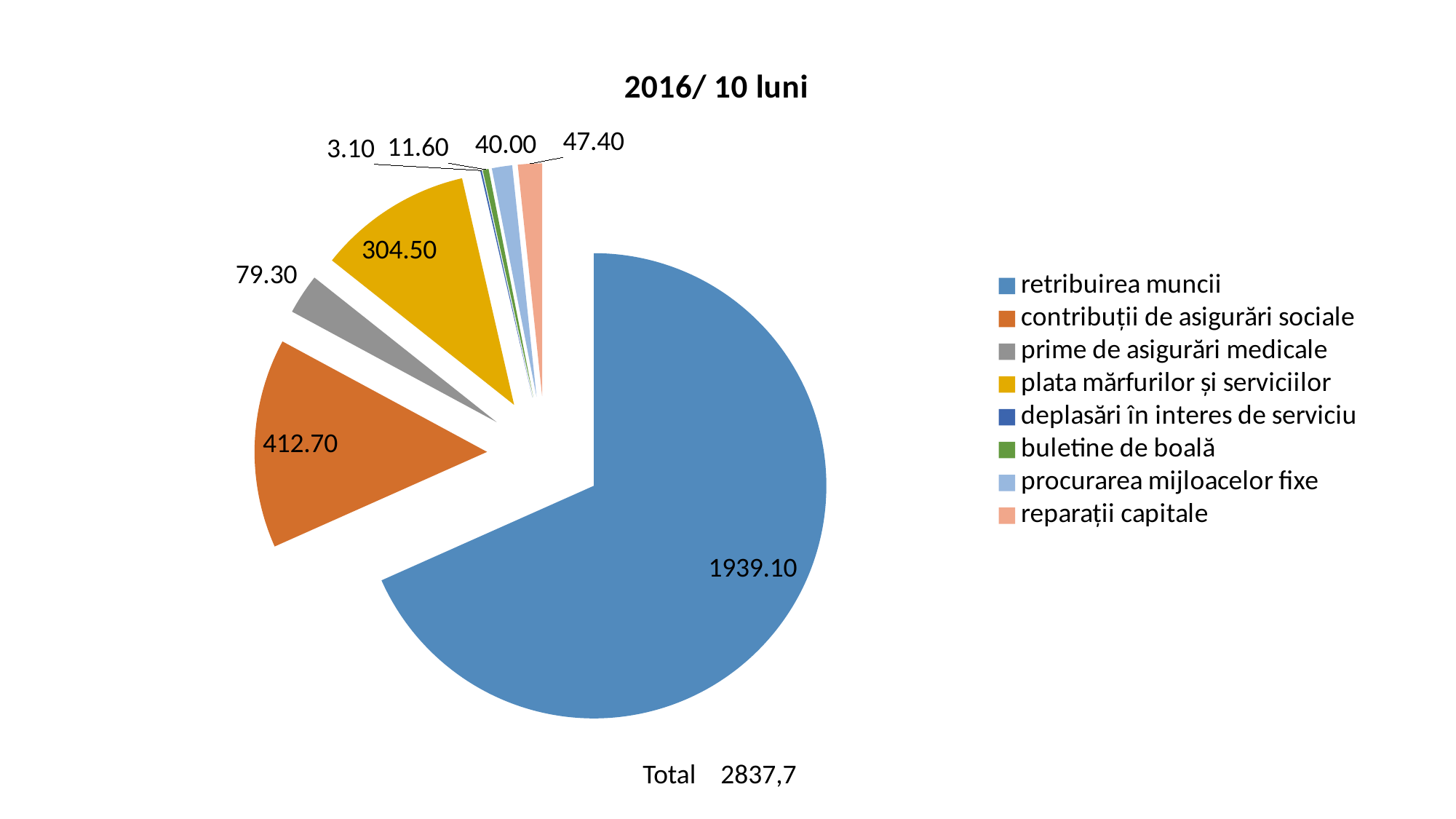
What is the difference between contribuții de asigurări sociale and plata mărfurilor și serviciilor? 108.20 Which category has the largest slice? retribuirea muncii What is the value for reparații capitale? 47.40 What is the value for contribuții de asigurări sociale? 412.70 What is the value for plata mărfurilor și serviciilor? 304.50 Which category has the smallest slice? deplasări în interes de serviciu What is the value for deplasări în interes de serviciu? 3.10 What is the value for retribuirea muncii? 1939.10 How many categories does the pie chart show? 8 What is the title of the chart? 2016/ 10 luni Which is larger, procurarea mijloacelor fixe or reparații capitale? reparații capitale What kind of chart is shown on the slide? pie chart